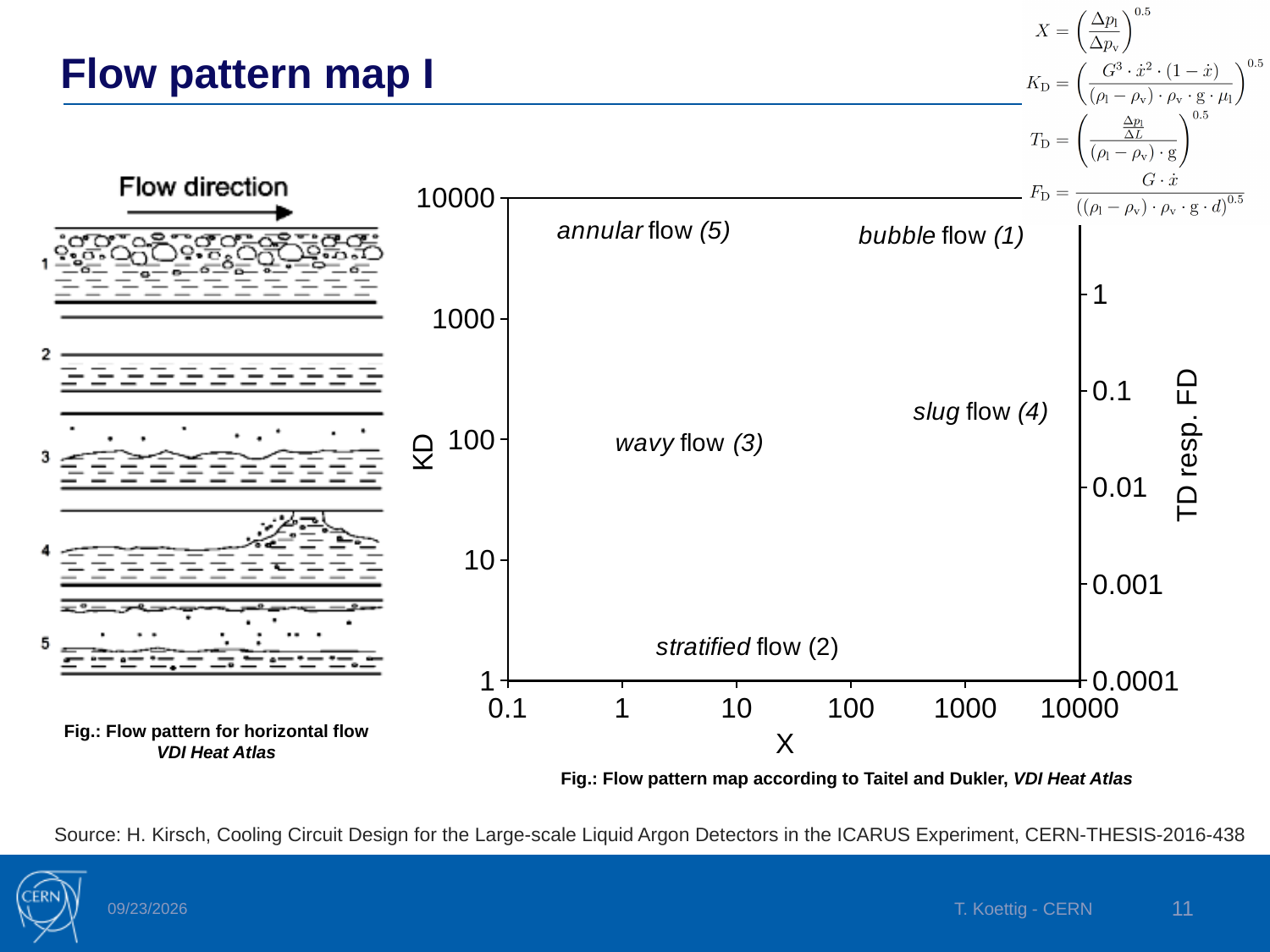
In the flow pattern map, what is the label of the horizontal axis? X In the flow pattern map, which flow regime is labelled with the number (5)? annular flow In the flow pattern map, what is the label of the right-hand vertical axis? TD resp. FD In the flow pattern map, which flow regime is labelled with the number (2)? stratified flow In the flow pattern map, how many flow regimes are labelled on the chart? 5